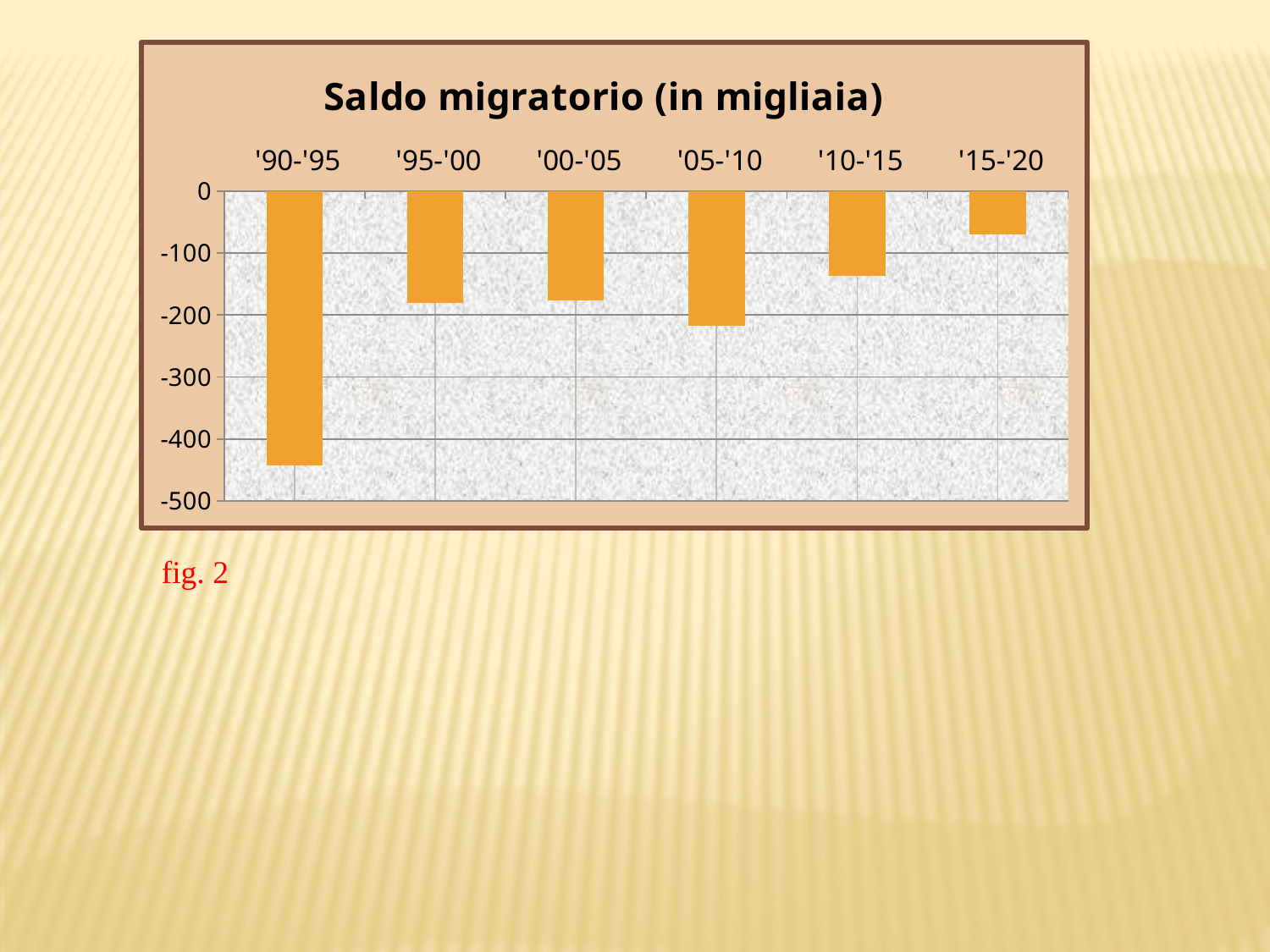
Which bar extends further below zero, '05-'10 or '10-'15? '05-'10 Is the value for '05-'10 greater or less than -200? less Which period has the bar closest to zero (the highest value)? '15-'20 What kind of chart is shown on the slide? bar chart Is the value for '15-'20 greater or less than -100? greater What is the title of the chart? Saldo migratorio (in migliaia) Which period has the bar that extends furthest below zero (the lowest value)? '90-'95 From '05-'10 to '15-'20, do the bars get shorter or longer? shorter How many periods (bars) are shown in the chart? 6 Is the value for '90-'95 greater or less than -400? less What is the lowest value shown on the vertical axis? -500